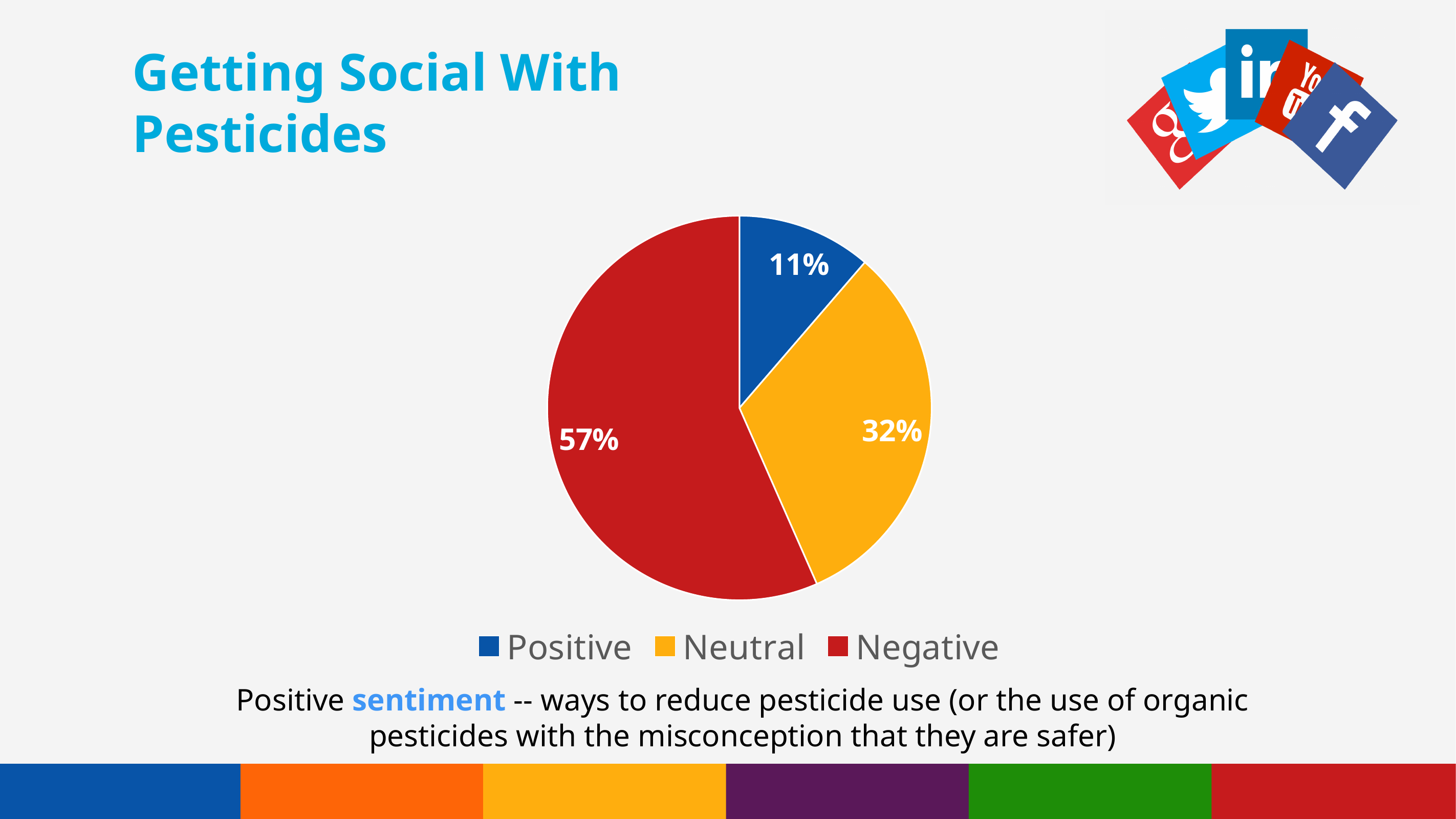
How many entries does the legend list? 3 Which category has the smallest share of the pie? Positive What percentage of the pie is Neutral? 32% What percentage of the pie is Positive? 11% What is the difference in percentage points between the Negative and Neutral slices? 25 What is the difference in percentage points between the Neutral and Positive slices? 21 What percentage of the pie is Negative? 57% What kind of chart is shown on the slide? pie chart How many slices does the pie chart have? 3 Which category has the largest share of the pie? Negative What colour is the Neutral slice? yellow Which is larger, the Neutral slice or the Positive slice? Neutral